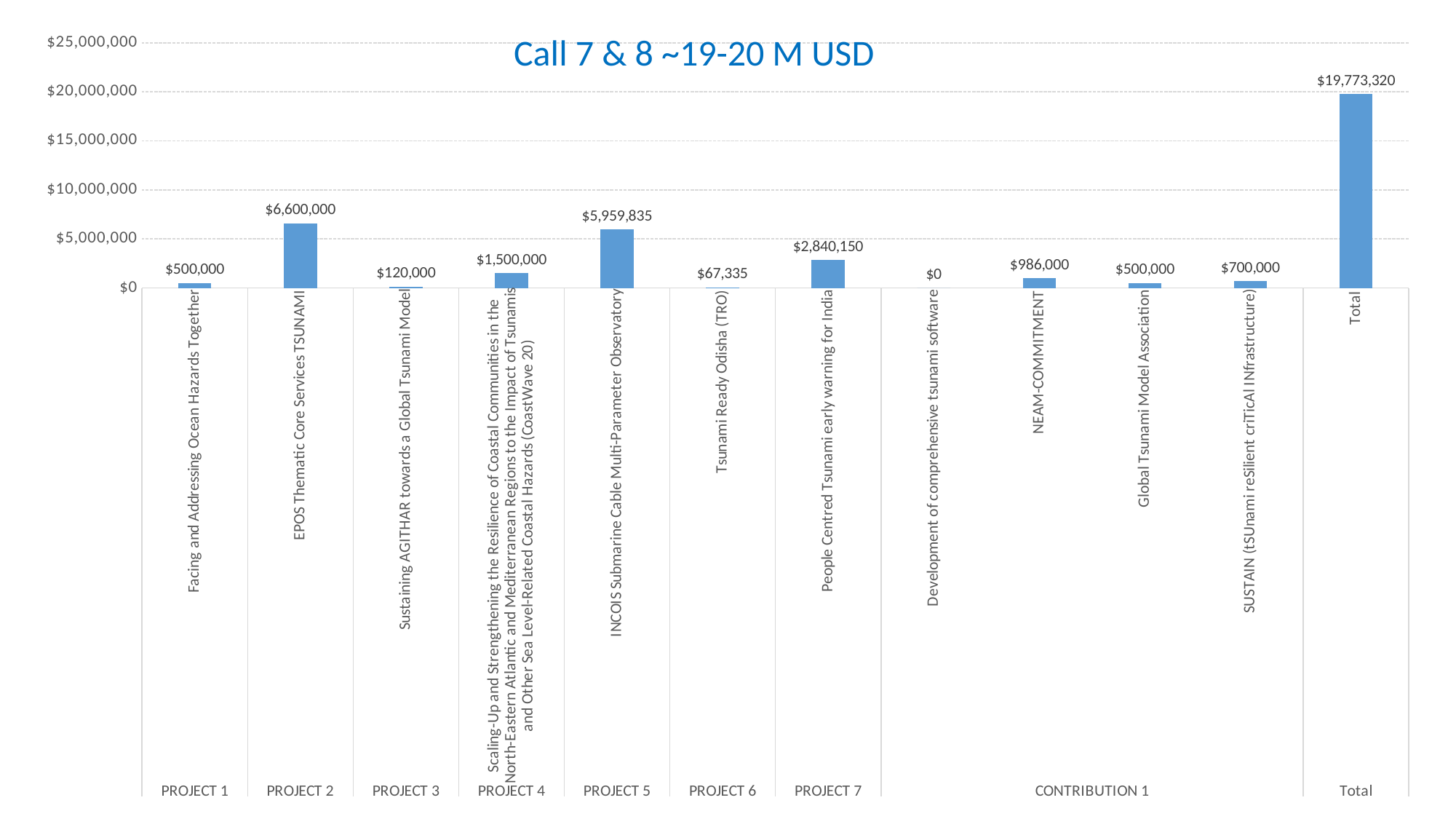
What is the value for NEAM-COMMITMENT? $986,000 Which is larger, the value for People Centred Tsunami early warning for India or the value for SUSTAIN (tSUnami reSilient criTicAl INfrastructure)? People Centred Tsunami early warning for India What is the title of the chart? Call 7 & 8 ~19-20 M USD What is the difference between the values for EPOS Thematic Core Services TSUNAMI and INCOIS Submarine Cable Multi-Parameter Observatory? $640,165 What is the value for INCOIS Submarine Cable Multi-Parameter Observatory? $5,959,835 Excluding the Total bar, which category has the highest value? EPOS Thematic Core Services TSUNAMI Which category has the lowest value? Development of comprehensive tsunami software What is the value for Tsunami Ready Odisha (TRO)? $67,335 How many bars are plotted in the chart, including the Total bar? 12 What is the value for EPOS Thematic Core Services TSUNAMI? $6,600,000 What is the value shown for the Total bar? $19,773,320 Is the value for the Total bar greater or less than $15,000,000? greater